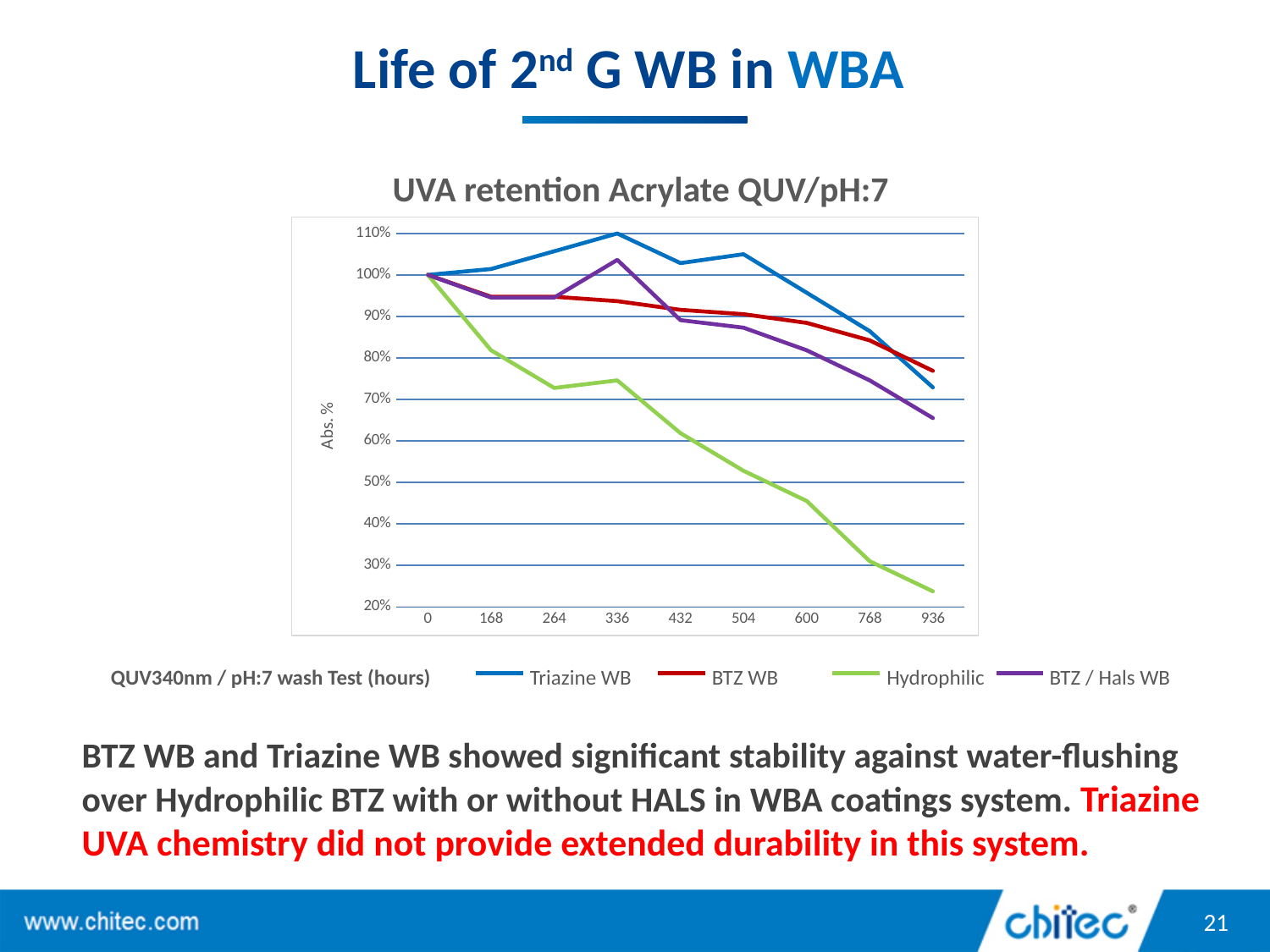
Is the value for Hydrophilic at 936 hours greater or less than 30%? less What is the title of the chart? UVA retention Acrylate QUV/pH:7 How many points are on the x axis of the chart? 9 What is the value for Hydrophilic at 0 hours? 100% Which series has the highest value at 336 hours? Triazine WB How many series does the legend list? 4 Does the Hydrophilic series rise or fall as the hours increase? fall What kind of chart is shown on the slide? line chart Is the value for BTZ / Hals WB at 936 hours greater or less than 60%? greater At 432 hours, which is larger: Triazine WB or Hydrophilic? Triazine WB Which series has the lowest value at 936 hours? Hydrophilic Is the value for Triazine WB at 504 hours greater or less than 100%? greater